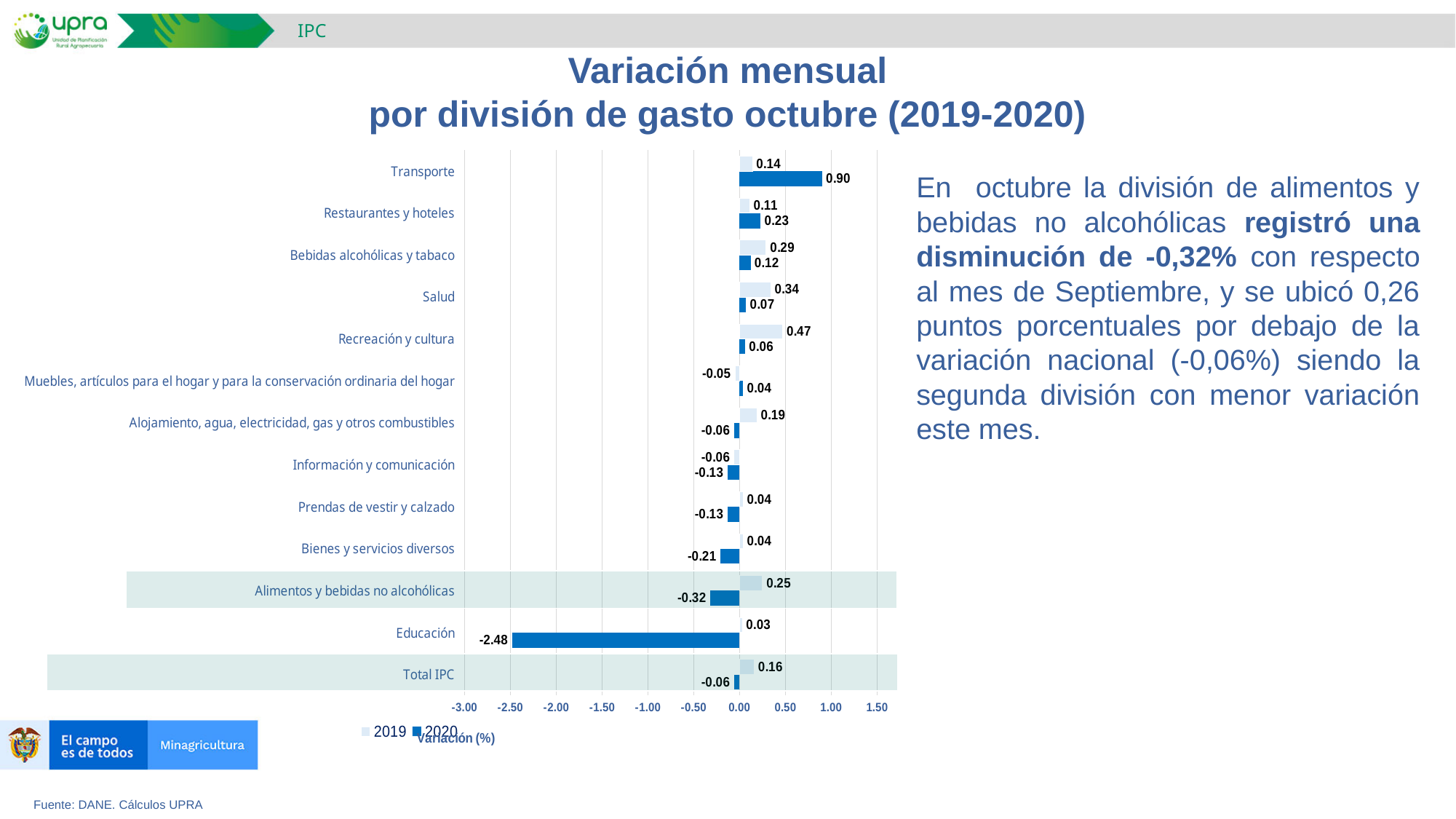
What is the 2020 value for Transporte? 0.90 Which is larger for Salud, the 2019 value or the 2020 value? 2019 How many series does the legend list? 2 What is the 2019 value for Recreación y cultura? 0.47 How many categories are shown on the chart? 13 Which category has the lowest 2020 value? Educación What is the 2020 value for Alimentos y bebidas no alcohólicas? -0.32 Which category has the highest 2020 value? Transporte What is the 2019 value for Total IPC? 0.16 Which category has the highest 2019 value? Recreación y cultura What is the difference between the 2020 and 2019 values for Transporte? 0.76 What is the 2020 value for Educación? -2.48